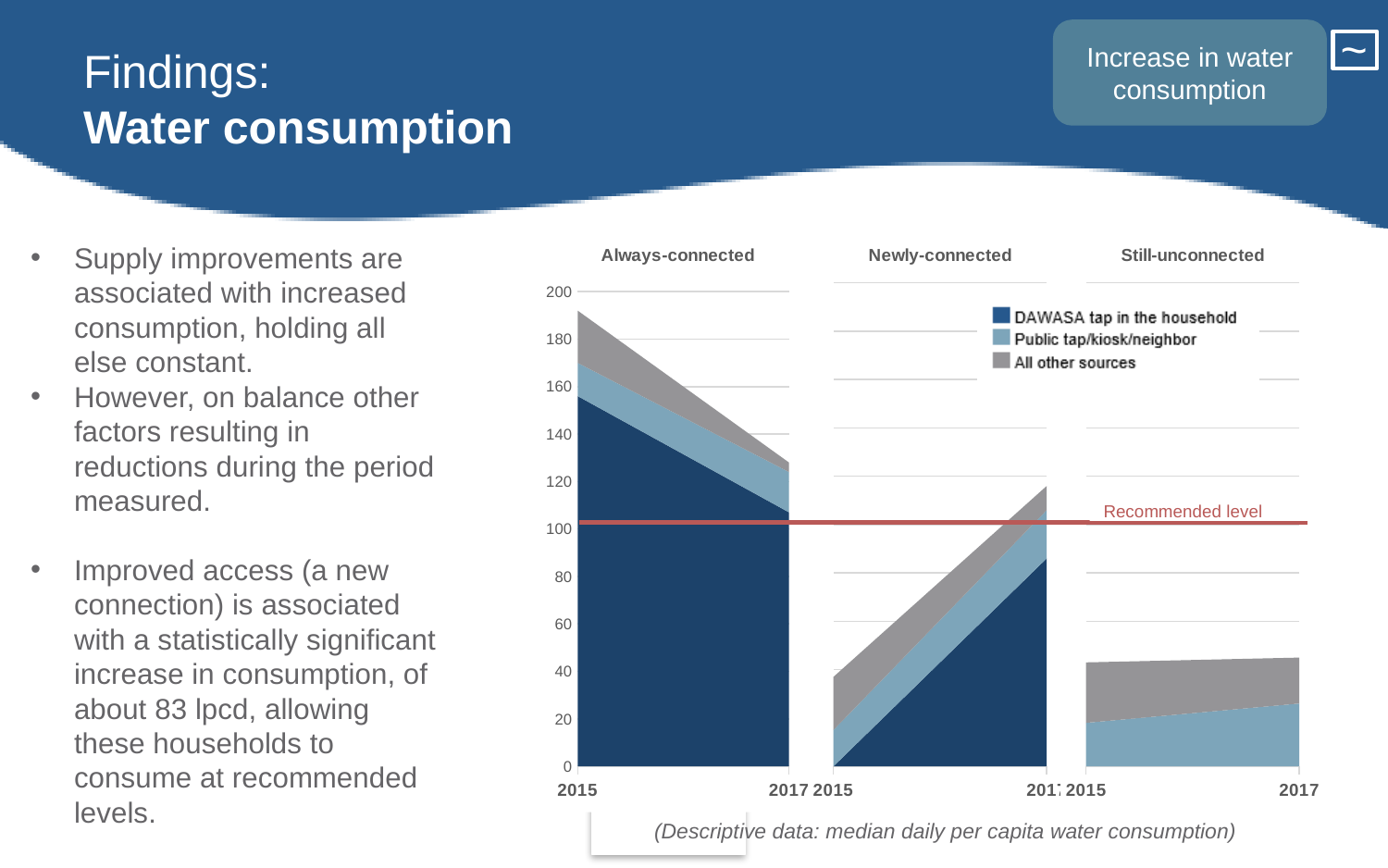
Is the total value for Newly-connected in 2017 greater or less than 100? greater What are the three series listed in the chart legend? DAWASA tap in the household, Public tap/kiosk/neighbor, All other sources How many series does the chart legend list? 3 In the Newly-connected panel, does total consumption rise or fall from 2015 to 2017? rise Is the total value for Newly-connected in 2015 greater or less than 60? less Is the total value for Always-connected in 2015 greater or less than 180? greater In the Always-connected panel, does total consumption rise or fall from 2015 to 2017? fall How many household groups (panels) does the chart show? 3 What does the red horizontal line on the chart represent? Recommended level What kind of chart is shown on the slide? area chart